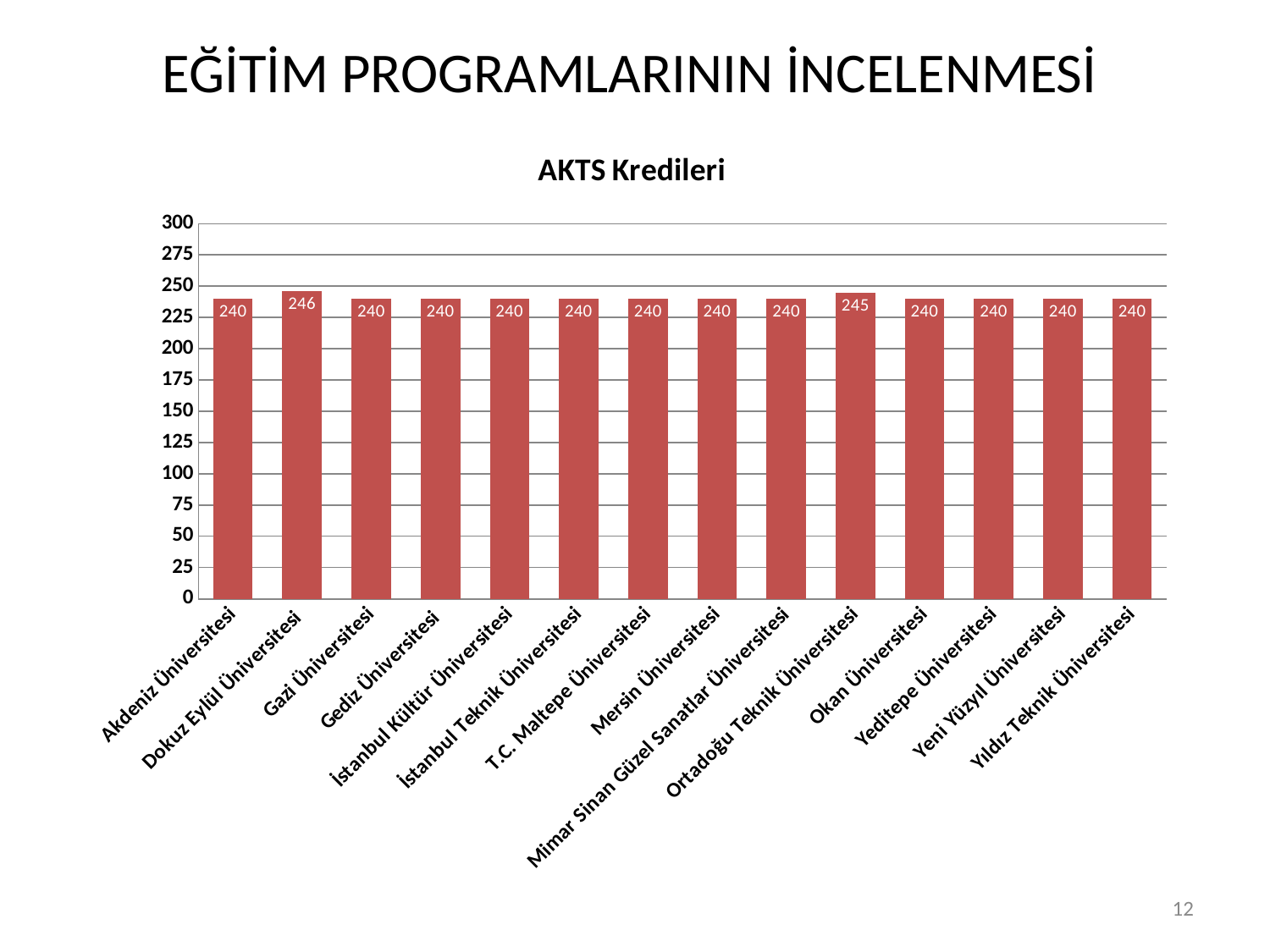
Which university has the highest AKTS credit value? Dokuz Eylül Üniversitesi What is the difference between the AKTS credits of Ortadoğu Teknik Üniversitesi and Mersin Üniversitesi? 5 Is the value for Yıldız Teknik Üniversitesi greater or less than 250? less What is the title of the chart? AKTS Kredileri How many universities are shown in the chart? 14 What is the difference between the AKTS credits of Dokuz Eylül Üniversitesi and Gazi Üniversitesi? 6 What is the AKTS credit value for Akdeniz Üniversitesi? 240 Which has more AKTS credits, Dokuz Eylül Üniversitesi or Ortadoğu Teknik Üniversitesi? Dokuz Eylül Üniversitesi What is the AKTS credit value for Dokuz Eylül Üniversitesi? 246 What is the maximum value shown on the vertical axis? 300 What kind of chart is shown on the slide? bar chart What is the AKTS credit value for Ortadoğu Teknik Üniversitesi? 245